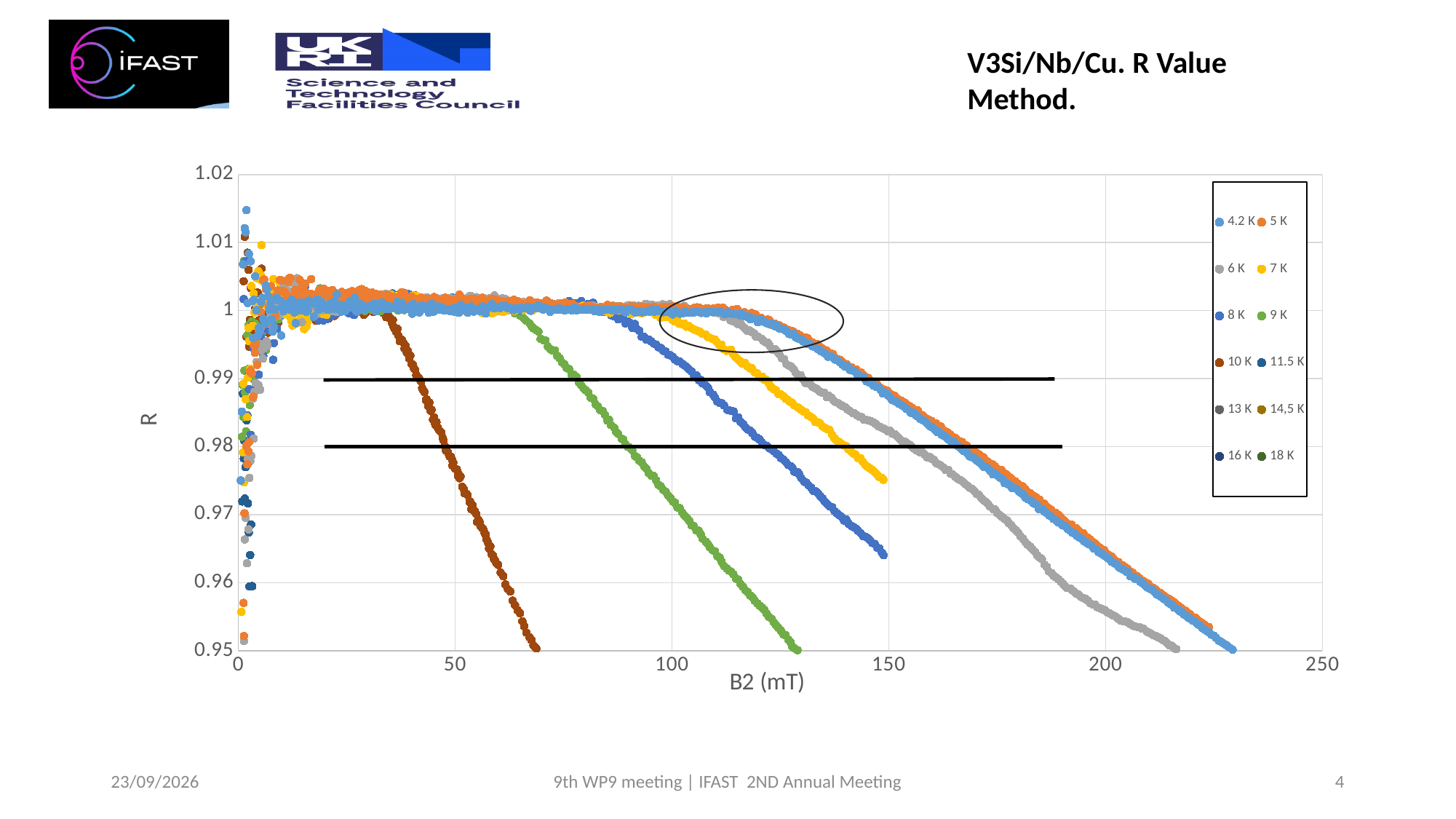
Is the value of R for the 7 K series at B2 = 150 mT greater or less than 0.98? less At B2 = 100 mT, which series has the larger R value, 9 K or 6 K? 6 K Is the value of R for the 5 K series at B2 = 100 mT greater or less than 0.99? greater Is the value of R for the 10 K series at B2 = 60 mT greater or less than 0.97? less What is the label of the x axis? B2 (mT) What kind of chart is shown on the slide? scatter chart How many series does the legend list? 12 What is the label of the y axis? R Which series begins to drop from R = 1 at the lowest B2 value? 10 K Does R rise or fall as B2 increases beyond about 100 mT for the 8 K series? fall